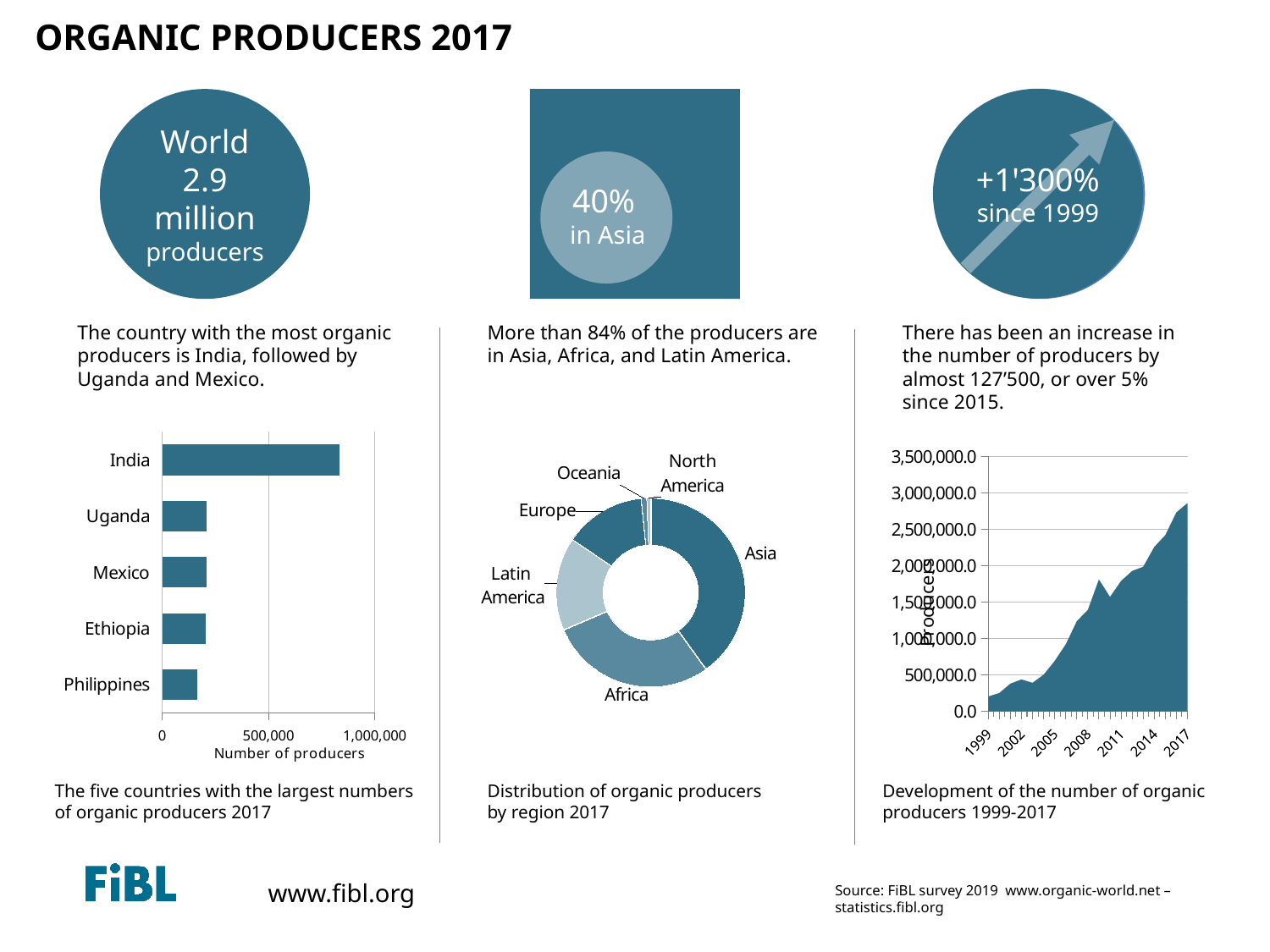
In the bar chart of the five countries with the largest numbers of organic producers, is the value for India greater or less than 500,000? greater In the chart of the development of the number of organic producers 1999-2017, do the values rise or fall from 1999 to 2017? rise How many regions are shown in the chart of the distribution of organic producers by region 2017? 6 In the bar chart of the five countries with the largest numbers of organic producers, which country has the highest value? India In the chart of the development of the number of organic producers 1999-2017, is the value for 2017 greater or less than 2,500,000.0? greater How many countries are shown in the bar chart of the five countries with the largest numbers of organic producers? 5 In the bar chart of the five countries with the largest numbers of organic producers, is the value for Uganda greater or less than 500,000? less In the bar chart of the five countries with the largest numbers of organic producers, which country has the lowest value? Philippines In the chart of the distribution of organic producers by region 2017, which is larger, Africa or Latin America? Africa In the chart of the distribution of organic producers by region 2017, which region has the largest share? Asia What is the x-axis title of the bar chart of the five countries with the largest numbers of organic producers? Number of producers What kind of chart is used for the five countries with the largest numbers of organic producers? bar chart